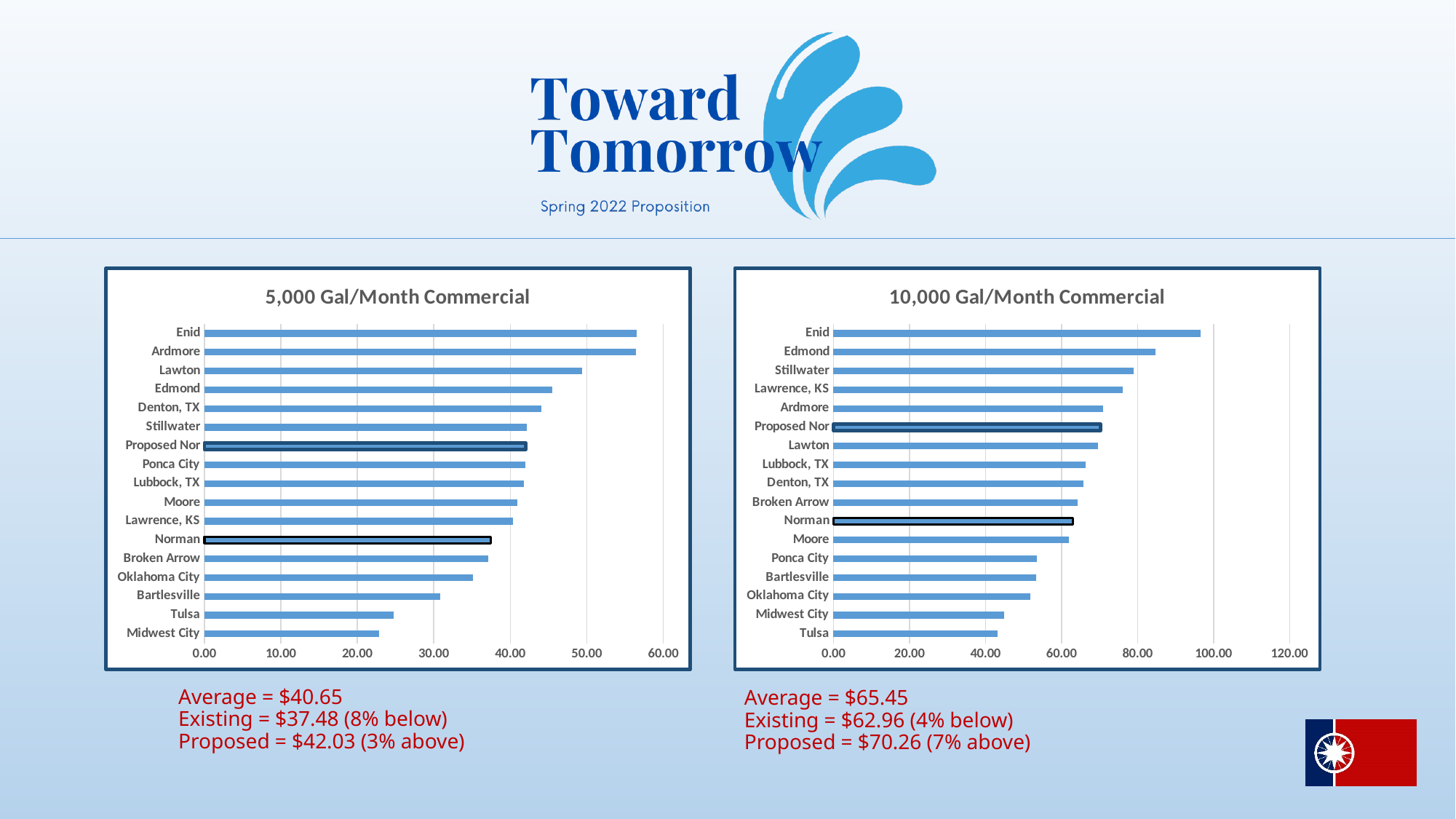
How many cities are listed in the '5,000 Gal/Month Commercial' chart? 17 In the '10,000 Gal/Month Commercial' chart, which city has the highest value? Enid How many cities are listed in the '10,000 Gal/Month Commercial' chart? 17 What is the title of the chart on the right side of the slide? 10,000 Gal/Month Commercial What kind of chart is the '5,000 Gal/Month Commercial' chart? bar chart In the '5,000 Gal/Month Commercial' chart, which two bars are outlined in dark borders? Proposed Nor and Norman In the '10,000 Gal/Month Commercial' chart, is the value for Edmond greater or less than 80.00? greater In the '5,000 Gal/Month Commercial' chart, is the value for Enid greater or less than 50.00? greater In the '5,000 Gal/Month Commercial' chart, which is larger, Lawton or Edmond? Lawton In the '5,000 Gal/Month Commercial' chart, is the value for Midwest City greater or less than 30.00? less In the '10,000 Gal/Month Commercial' chart, which is larger, Stillwater or Ponca City? Stillwater